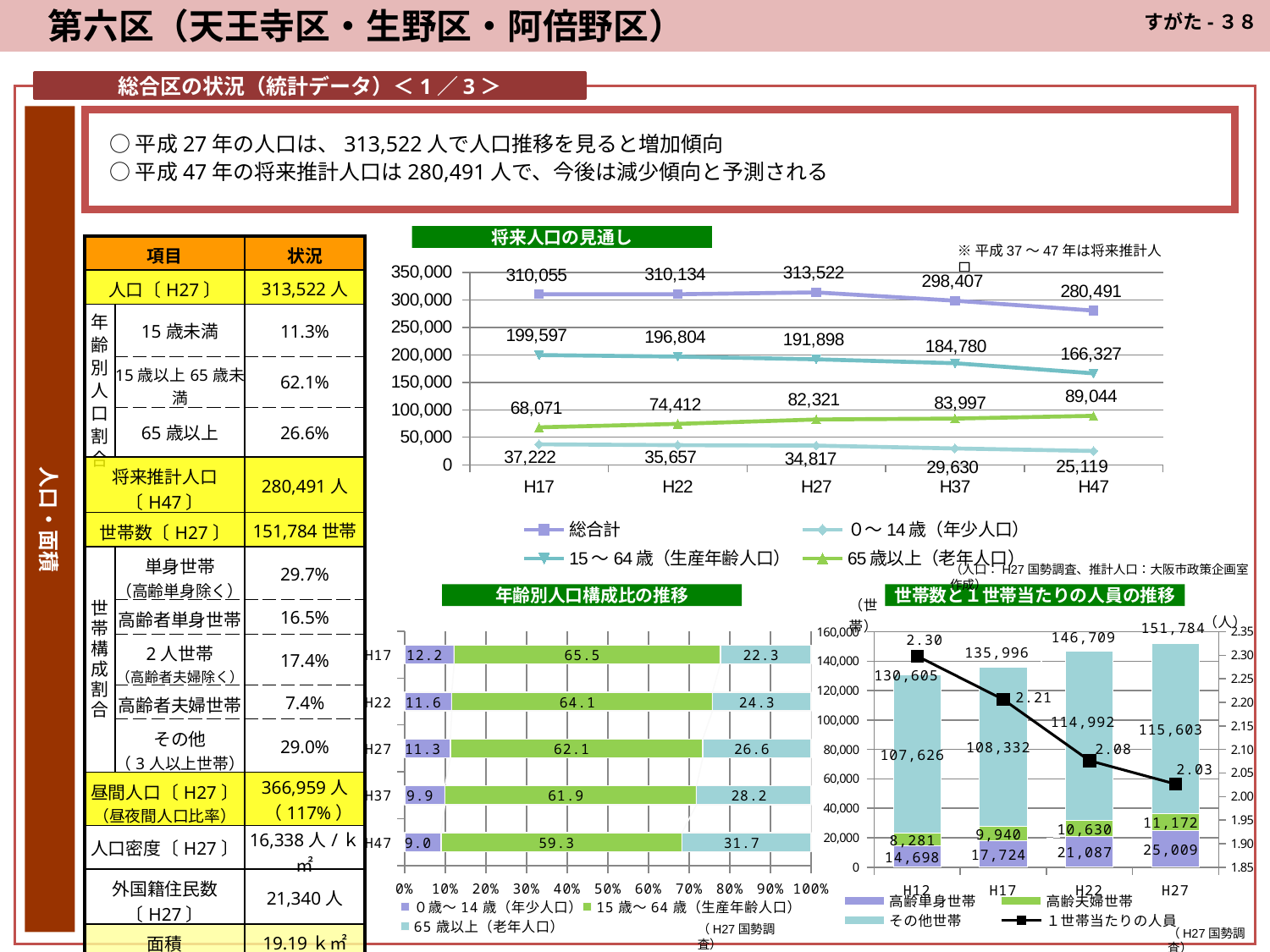
In the 将来人口の見通し chart, does the 0～14歳（年少人口） series rise or fall from H17 to H47? fall In the 将来人口の見通し chart, how many series does the legend list? 4 In the 世帯数と１世帯当たりの人員の推移 chart, which is larger, the その他世帯 value for H22 or for H27? H27 In the 世帯数と１世帯当たりの人員の推移 chart, what is the 高齢単身世帯 value for H27? 25,009 In the 将来人口の見通し chart, what is the difference between the 15～64歳（生産年齢人口） values for H17 and H47? 33,270 In the 年齢別人口構成比の推移 chart, which year has the highest share of 65歳以上（老年人口）? H47 In the 年齢別人口構成比の推移 chart, what is the share of 15～64歳（生産年齢人口） for H47? 59.3 In the 将来人口の見通し chart, what is the value for 65歳以上（老年人口） in H47? 89,044 In the 世帯数と１世帯当たりの人員の推移 chart, how many years are shown on the x axis? 4 In the 世帯数と１世帯当たりの人員の推移 chart, what is the 1世帯当たりの人員 value for H12? 2.30 In the 将来人口の見通し chart, what is the 総合計 value for H27? 313,522 What kind of chart is the 年齢別人口構成比の推移 chart? stacked bar chart